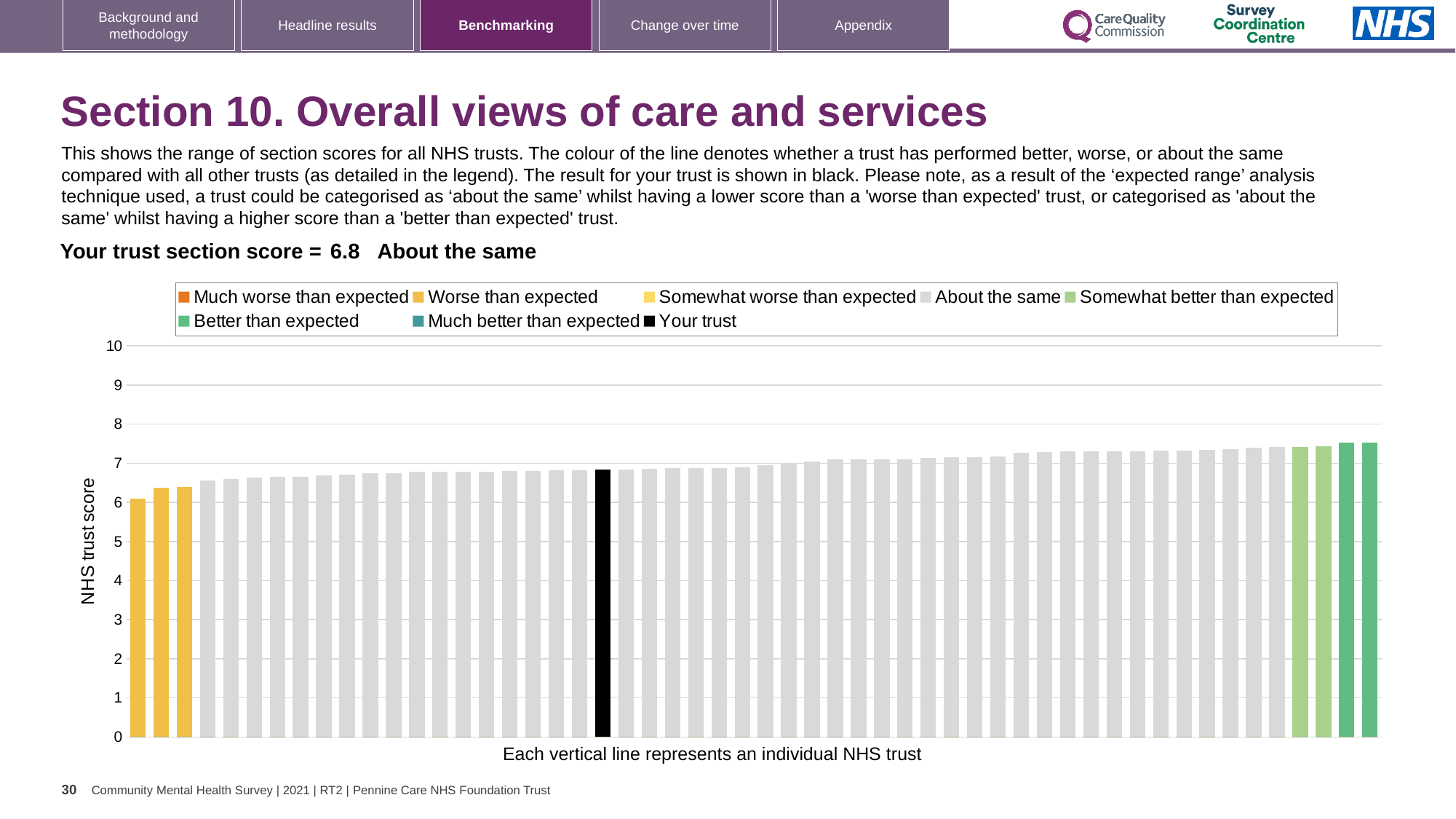
How many entries does the chart legend list? 8 Which category is your trust placed in for this section? About the same How many bars are coloured as 'Better than expected' (dark green)? 2 What is the label on the vertical axis of the chart? NHS trust score Is the lowest bar in the chart greater or less than 7? less What is the section score for your trust? 6.8 What kind of chart is shown on the slide? bar chart Do the bar values rise or fall from left to right along the x axis? rise How many bars are coloured as 'Worse than expected' (yellow)? 3 What colour is the bar representing your trust? black Is the value for your trust (the black bar) greater or less than 6? greater Is the highest bar in the chart greater or less than 8? less